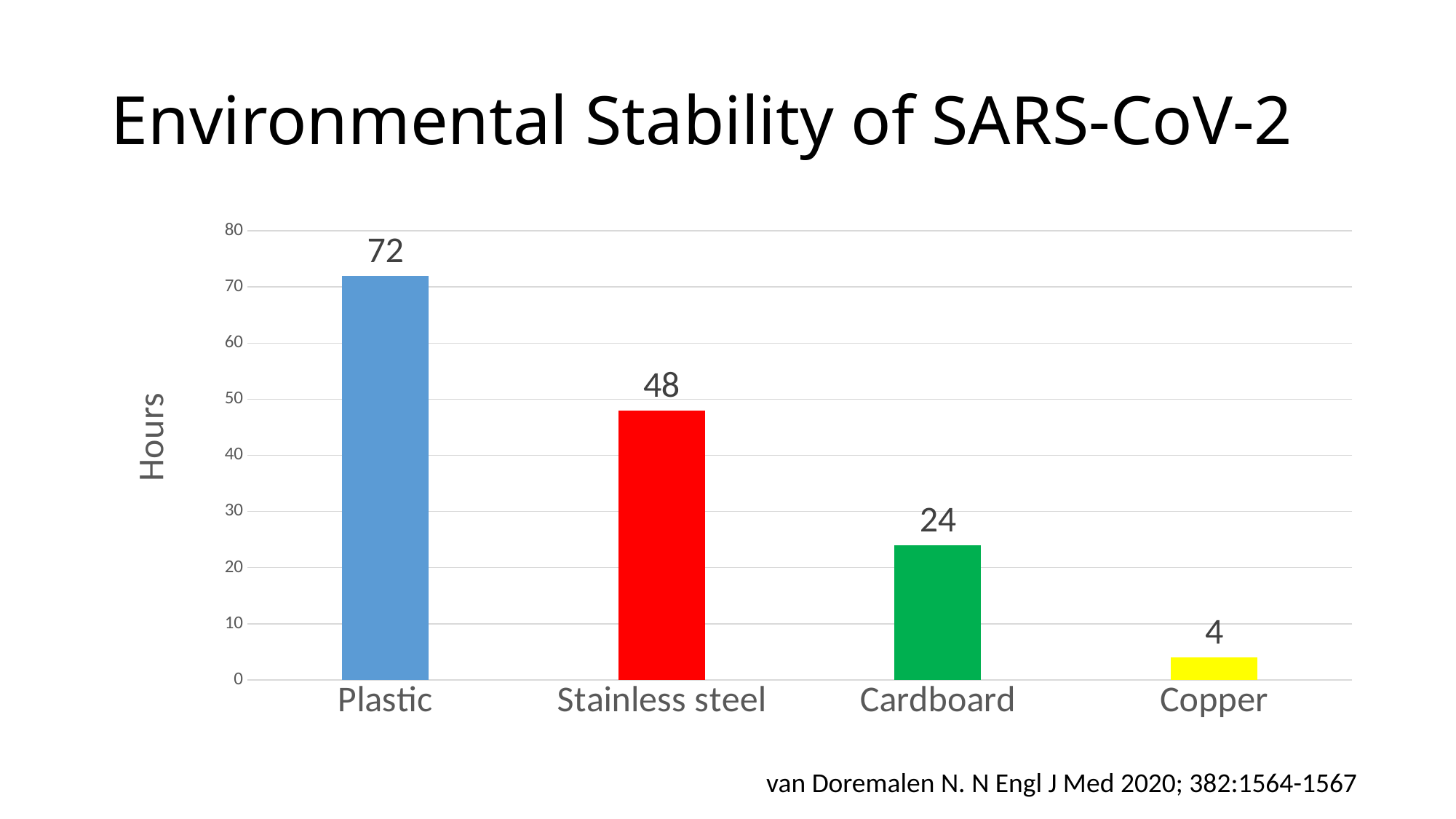
What is the value for Copper? 4 What is the value for Cardboard? 24 What is the value for Stainless steel? 48 Which category has the lowest value? Copper What is the difference between the values for Plastic and Stainless steel? 24 Which category has the highest value? Plastic Which is larger, the value for Stainless steel or the value for Cardboard? Stainless steel How many hours is the value for Plastic? 72 Do the values rise or fall from left to right along the x axis? Fall What kind of chart is shown on the slide? Bar chart How many categories are shown on the x axis? 4 What is the difference between the values for Cardboard and Copper? 20